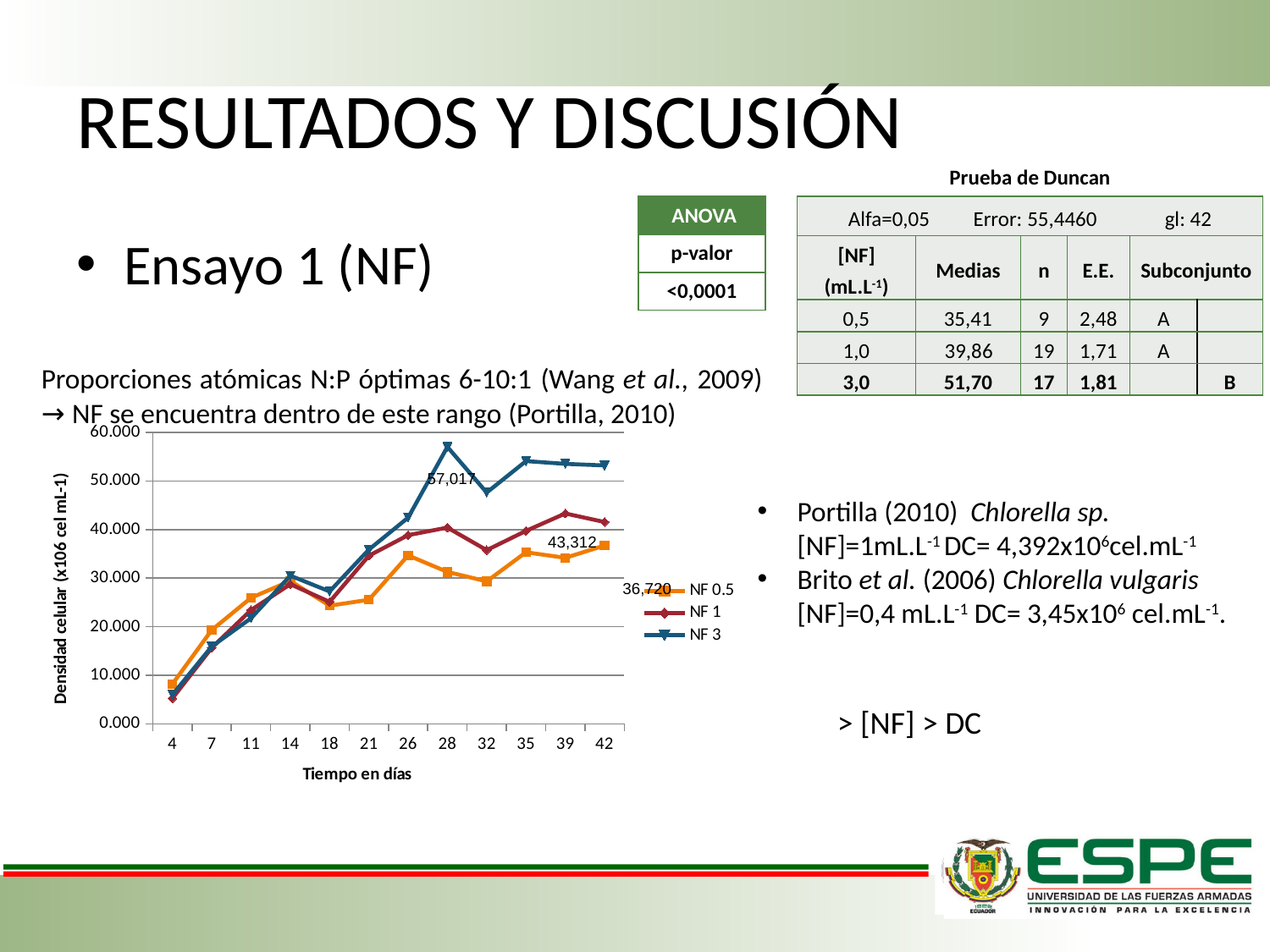
How many series does the chart legend list? 3 Does the NF 3 series rise or fall from day 4 to day 28? rise What is the labeled value of the NF 0.5 series at day 42? 36,720 At day 42, which series has the larger value, NF 3 or NF 0.5? NF 3 What is the labeled value of the NF 3 series at day 28? 57,017 What is the labeled value of the NF 1 series at day 39? 43,312 What type of chart is shown on the slide? line chart Is the value of the NF 3 series at day 42 greater or less than 50.000? greater What is the title of the x axis of the chart? Tiempo en días Which series reaches the highest cell density in the chart? NF 3 How many time points (days) are shown on the x axis of the chart? 12 Is the value of the NF 0.5 series at day 4 greater or less than 10.000? less